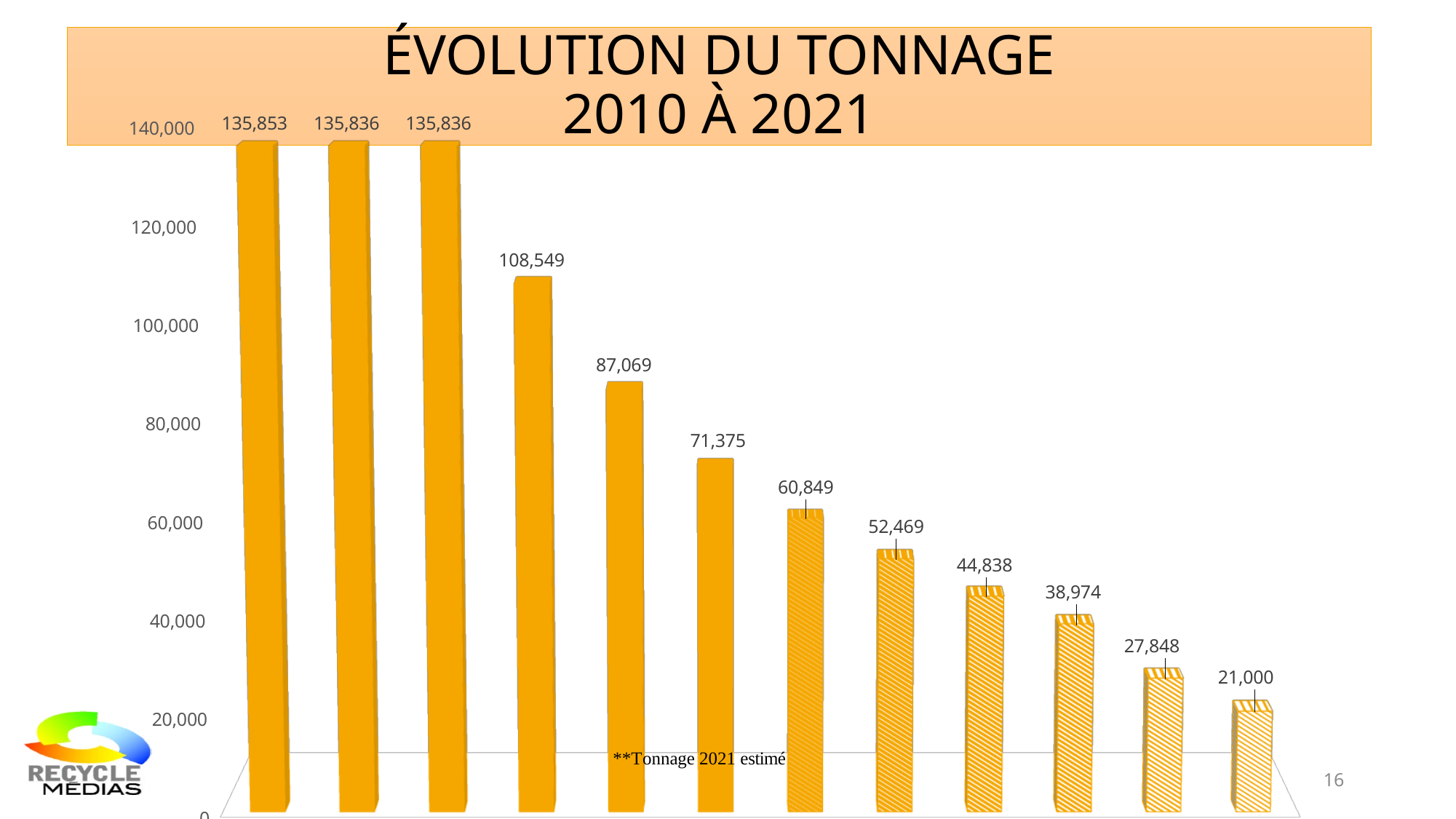
What is the value shown on the fourth bar from the left? 108,549 What is the difference between the first bar (135,853) and the last bar (21,000)? 114,853 Do the values generally rise or fall from left to right across the chart? fall What type of chart is shown on the slide? bar chart What is the value shown on the first (leftmost) bar? 135,853 What is the value shown on the last (rightmost) bar? 21,000 What is the value shown on the seventh bar from the left? 60,849 How many bars are plotted in the chart? 12 What is the title of the chart? ÉVOLUTION DU TONNAGE 2010 À 2021 Which is larger, the fifth bar from the left or the sixth bar from the left? the fifth bar (87,069) What does the note at the bottom of the chart say about the 2021 tonnage? Tonnage 2021 estimé Which bar has the lowest value? the last (rightmost) bar, 21,000